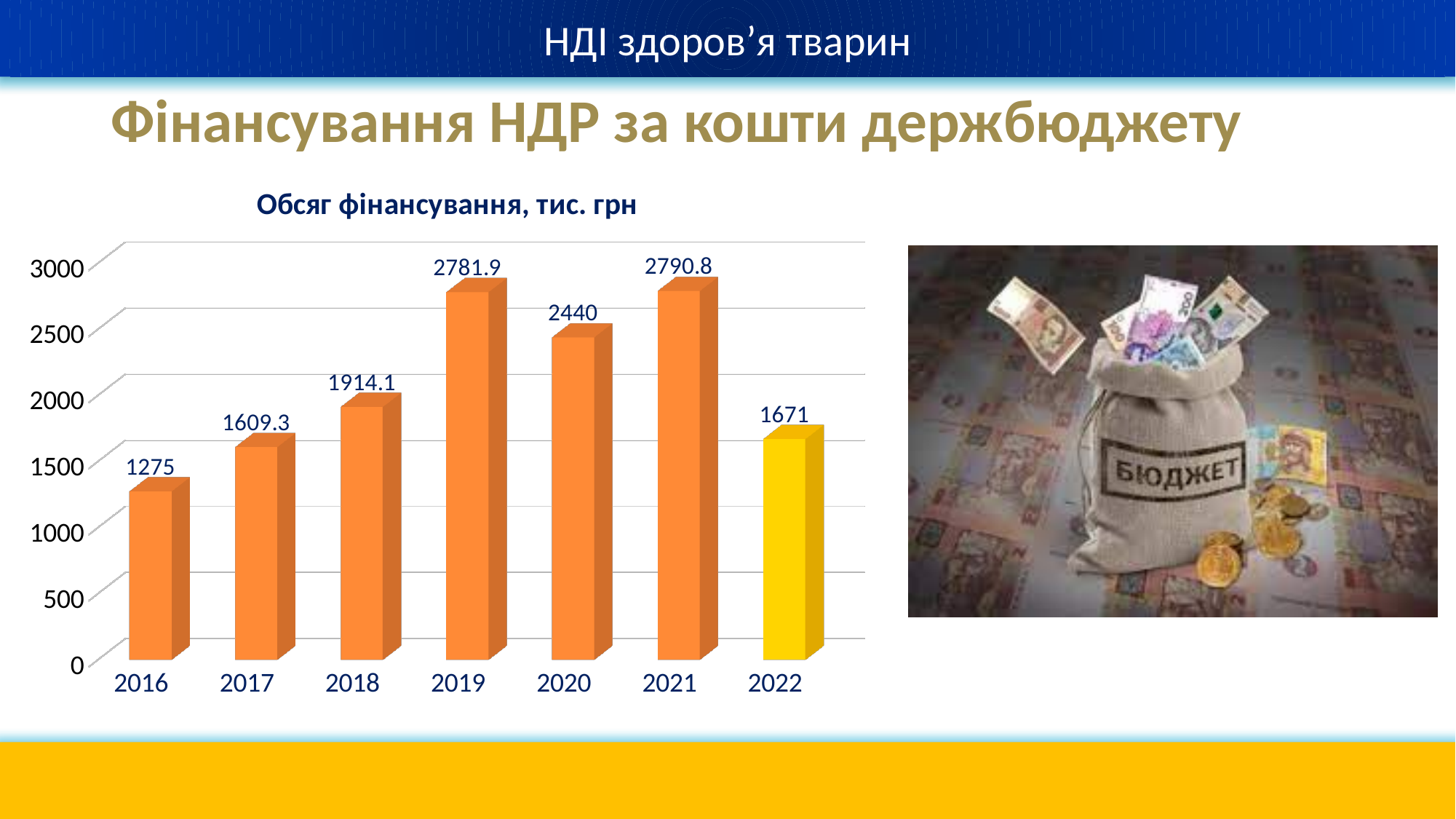
What kind of chart is shown on the slide? bar chart What is the difference between the values for 2021 and 2020? 350.8 What is the value for 2016? 1275 What is the value for 2019? 2781.9 What is the value for 2022? 1671 How many years are shown on the x axis? 7 Which is larger, the value for 2018 or the value for 2020? 2020 Which year has the lowest value? 2016 Which year has the highest value? 2021 Do the values rise or fall from 2016 to 2019? rise What is the difference between the values for 2022 and 2016? 396 Is the value for 2022 greater or less than 2000? less